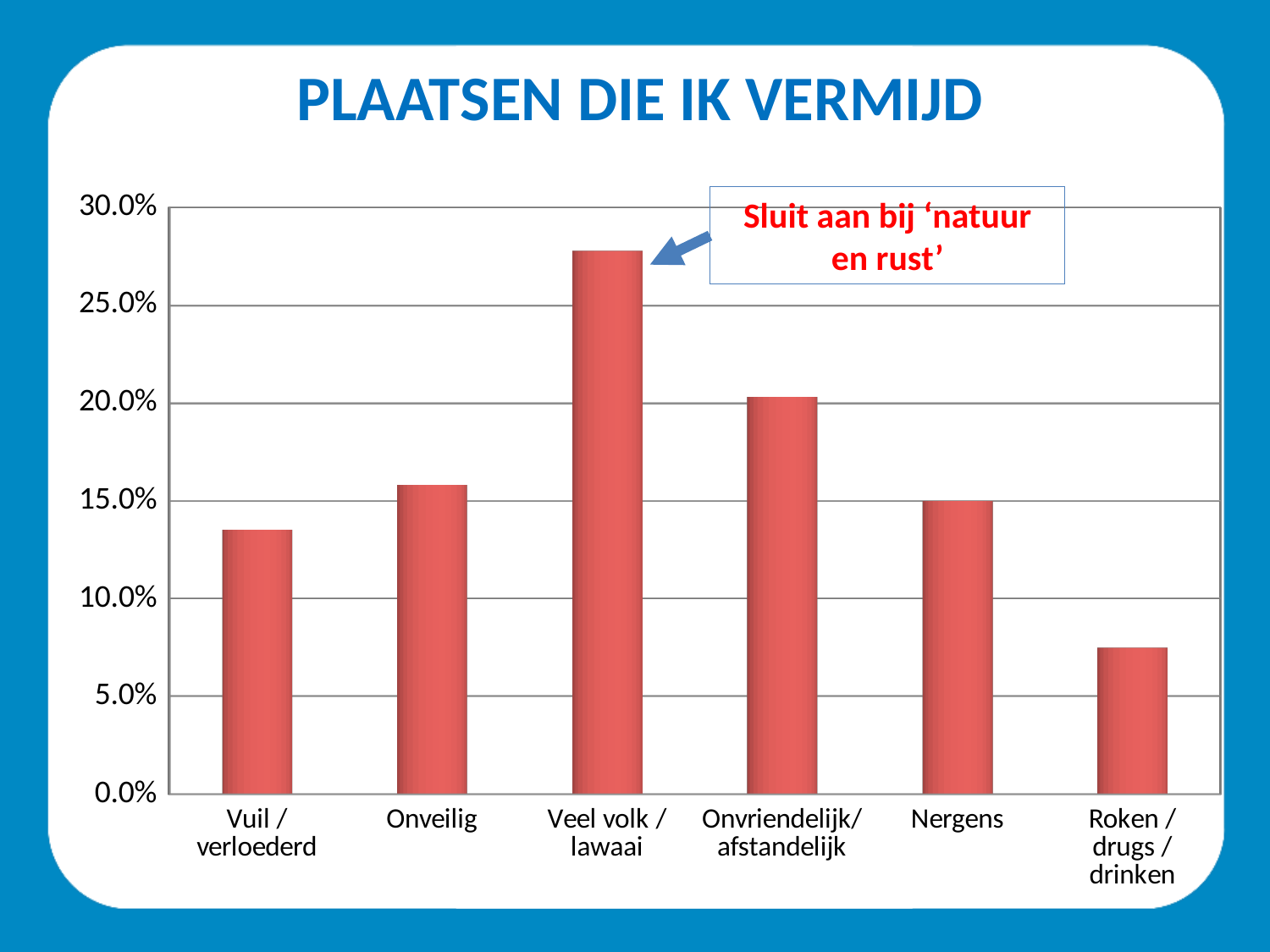
What is the title of the slide? PLAATSEN DIE IK VERMIJD Is the value for Vuil / verloederd greater or less than 15.0%? less Which category has the lowest value? Roken / drugs / drinken What does the annotation box pointing at the tallest bar say? Sluit aan bij 'natuur en rust' Is the value for Veel volk / lawaai greater or less than 25.0%? greater Is the value for Roken / drugs / drinken greater or less than 10.0%? less Which category has the highest value? Veel volk / lawaai How many categories are shown on the x axis? 6 What kind of chart is shown on the slide? bar chart Which is larger, the value for Onvriendelijk/ afstandelijk or the value for Nergens? Onvriendelijk/ afstandelijk Which is larger, the value for Onveilig or the value for Vuil / verloederd? Onveilig